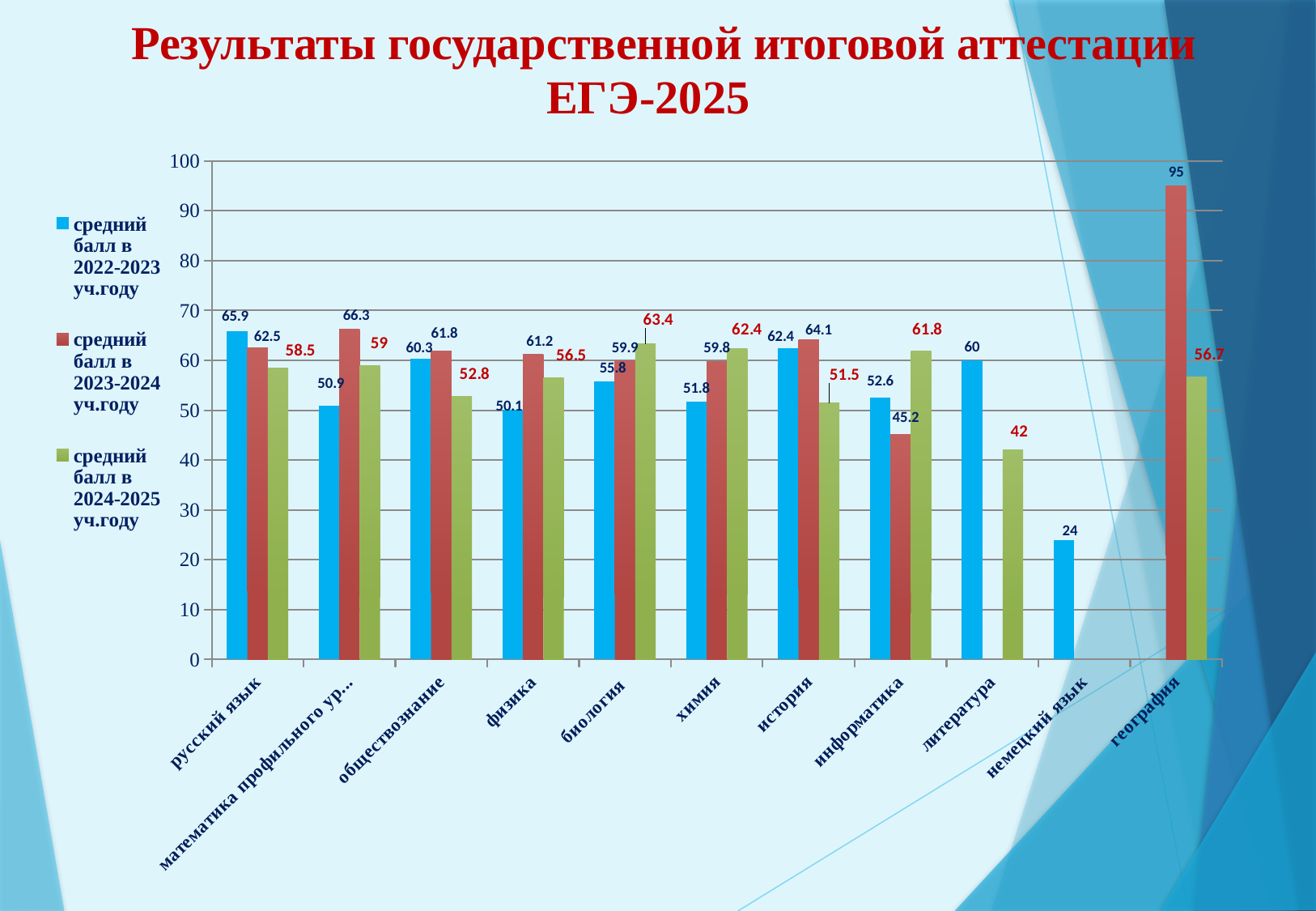
What is the average score for русский язык in the 2022-2023 school year? 65.9 Which subject has the highest average score in the 2023-2024 school year? география What kind of chart is shown on the slide? bar chart Which subject has the lowest average score in the 2022-2023 school year? немецкий язык How many series does the legend list? 3 For биология, do the average scores rise or fall from 2022-2023 to 2024-2025? rise For информатика, which is larger: the average score in 2023-2024 or in 2024-2025? 2024-2025 What is the difference between the average score for русский язык in 2022-2023 and in 2024-2025? 7.4 What is the average score for география in the 2023-2024 school year? 95 What is the title of the slide? Результаты государственной итоговой аттестации ЕГЭ-2025 How many subject categories are shown on the x axis? 11 What is the average score for литература in the 2024-2025 school year? 42